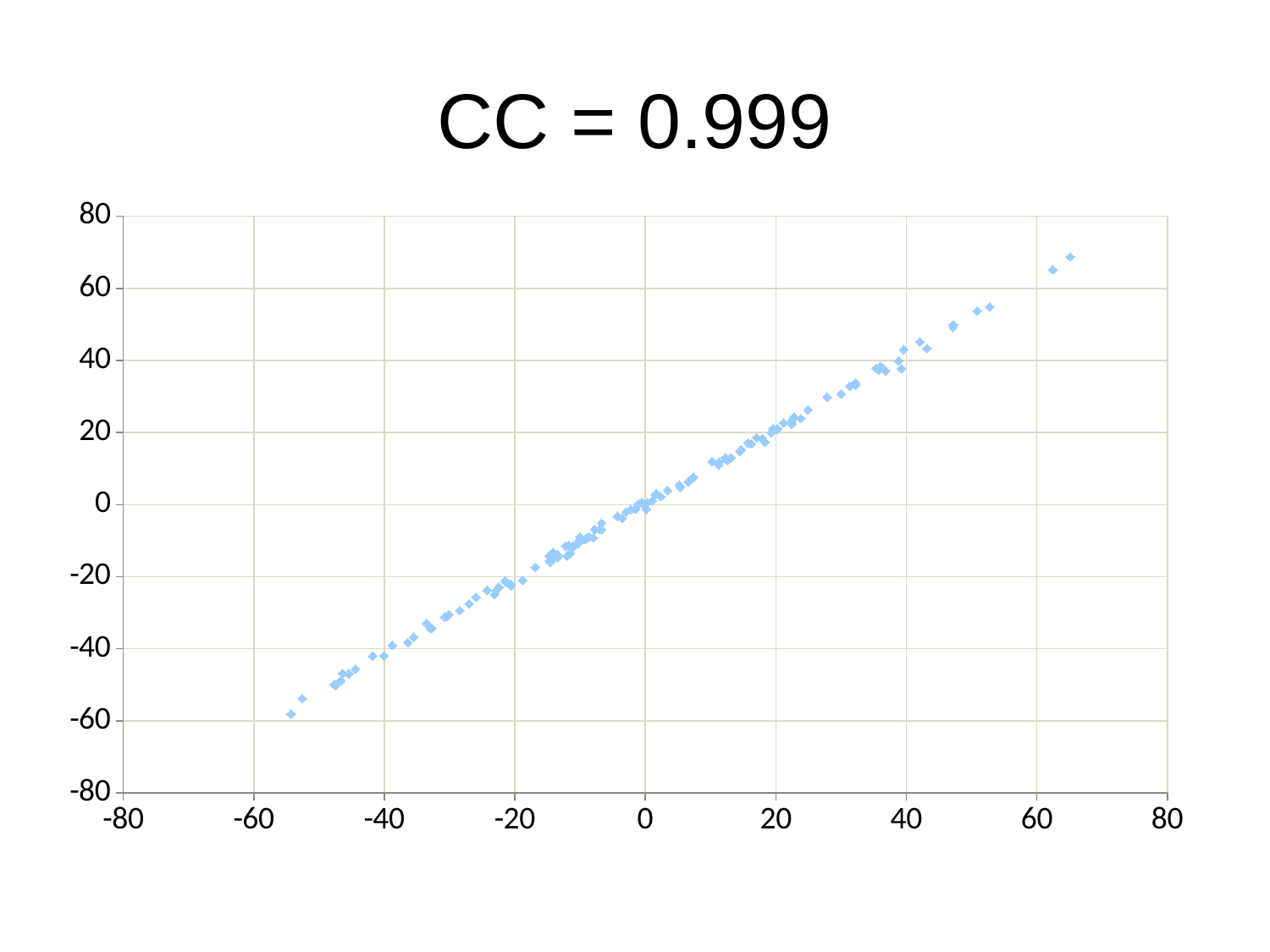
What are the minimum and maximum values shown on the x axis? -80 and 80 What kind of chart is shown on the slide? scatter plot Is the x value of the rightmost plotted point greater or less than 60? greater Is the y value of the highest plotted point greater or less than 60? greater Is the x value of the leftmost plotted point greater or less than -40? less What is the title of the chart? CC = 0.999 Do the plotted y values rise or fall as the x values increase? rise